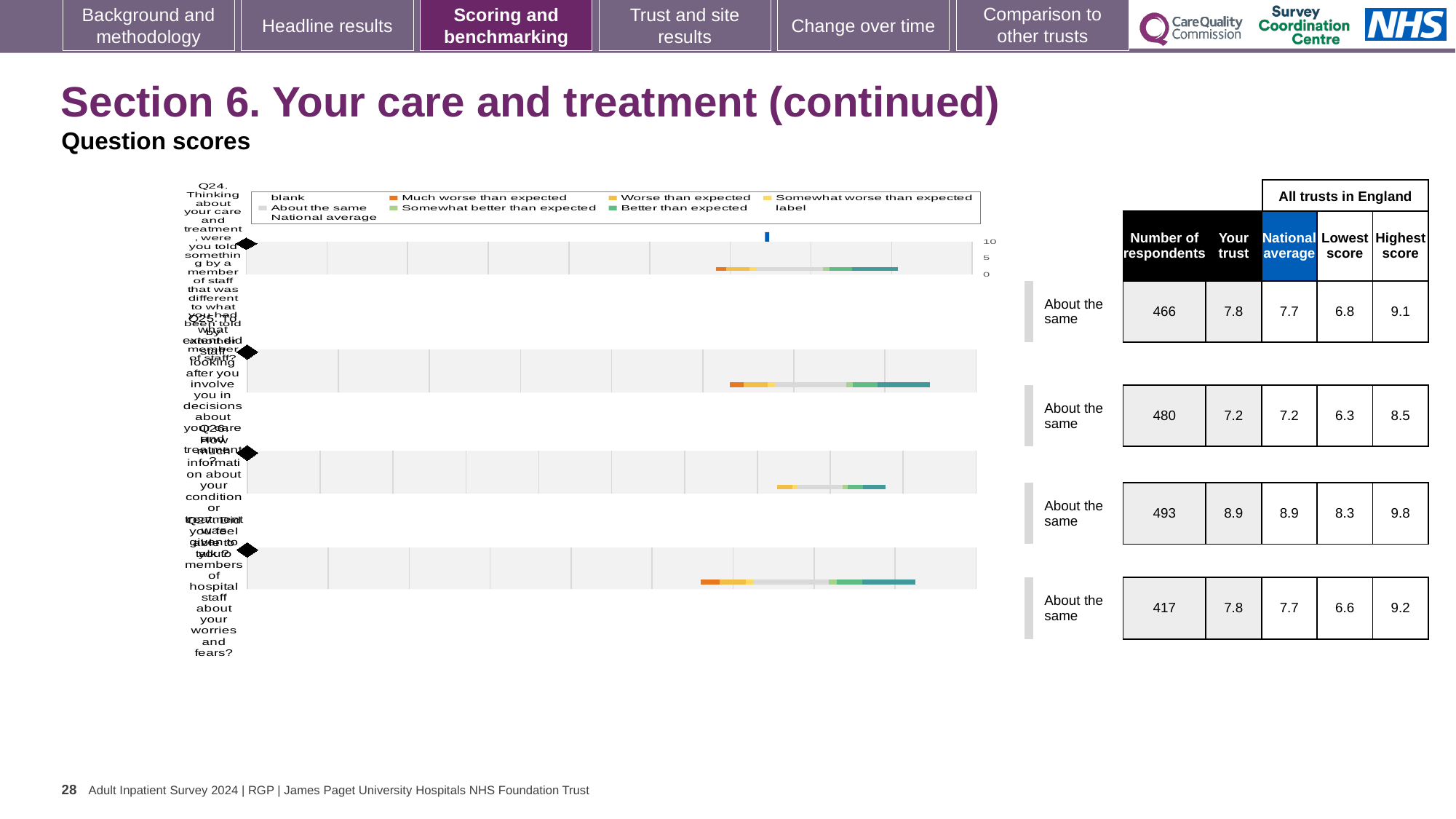
Which question number is the last (bottom) bar of the chart about? Q27 How many entries does the legend of the chart list? 9 Which legend entry is shown in light grey in the chart's legend? About the same What is the highest tick value shown on the chart's axis? 10 Which legend entry is shown in orange in the chart's legend? Much worse than expected Which question number is the first (top) bar of the chart about? Q24 How many question rows (bars) does the chart on the left show? 4 What kind of chart is shown on the left of the slide? bar chart